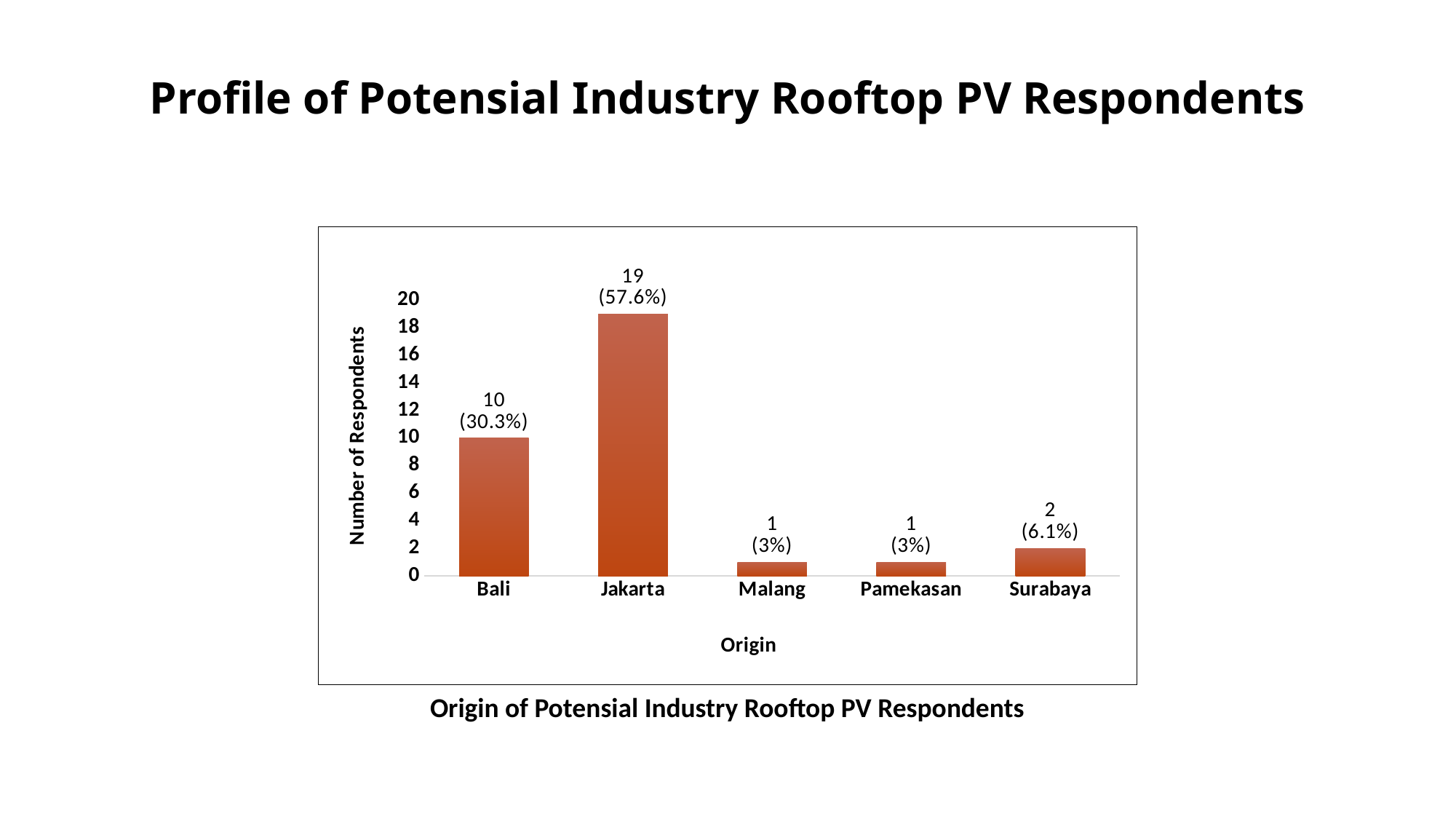
Which origin has the highest number of respondents? Jakarta How many respondents are from Bali? 10 What kind of chart is shown on the slide? Bar chart What is the difference in the number of respondents between Jakarta and Bali? 9 Which has more respondents, Surabaya or Malang? Surabaya What is the total number of respondents across all five origins? 33 What is the label of the y axis? Number of Respondents How many respondents are from Jakarta? 19 How many respondents are from Pamekasan? 1 What is the caption below the chart? Origin of Potensial Industry Rooftop PV Respondents How many origin categories are shown on the x axis? 5 What percentage of respondents are from Surabaya? 6.1%